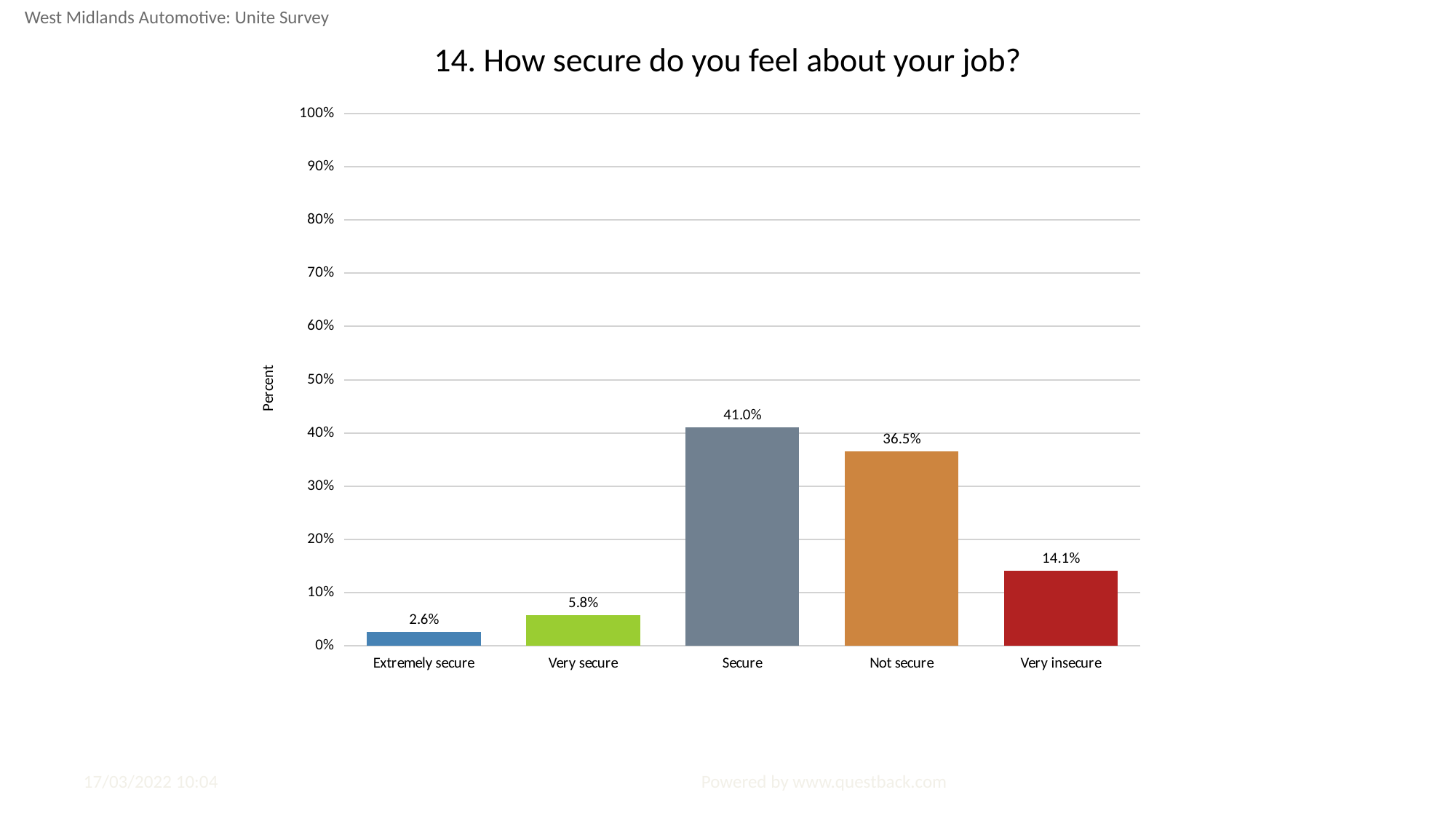
What is the difference between the values for 'Very insecure' and 'Very secure'? 8.3% What is the value shown for 'Very insecure'? 14.1% Is the value for 'Not secure' greater or less than 40%? less What is the difference between the values for 'Secure' and 'Not secure'? 4.5% Which category has the lowest value? Extremely secure What kind of chart is shown on the slide? Bar chart What percentage is shown for 'Extremely secure'? 2.6% Which is larger, the value for 'Not secure' or the value for 'Very insecure'? Not secure How many categories are shown on the x axis? 5 What is the label of the y axis? Percent Which category has the highest value? Secure What percentage of respondents said they feel 'Secure' about their job? 41.0%